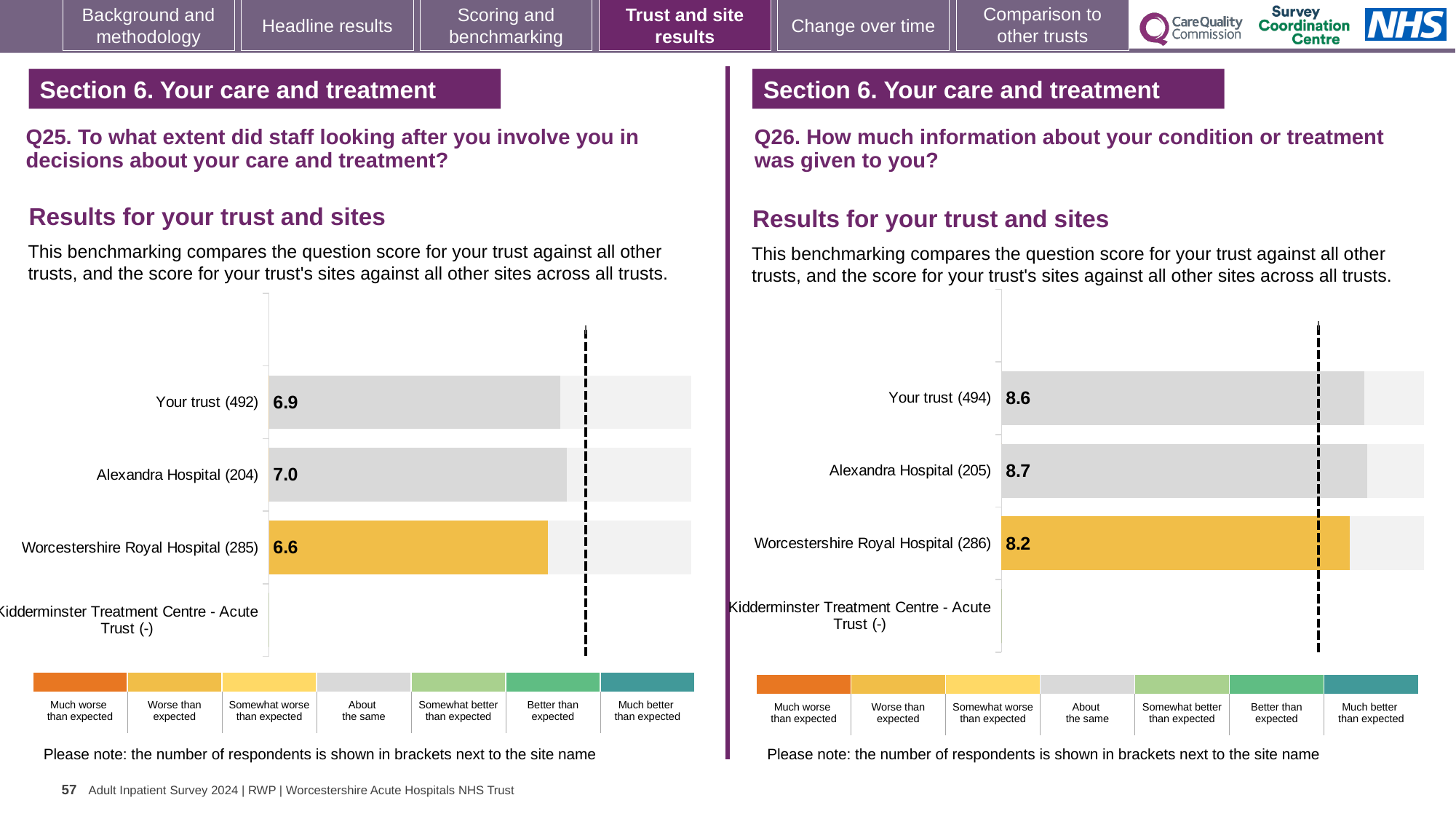
What type of chart is used for the Q26 results (right)? Bar chart On the Q26 chart (right), what is the score for Alexandra Hospital (205)? 8.7 On the Q26 chart (right), which has the larger score: Your trust (494) or Worcestershire Royal Hospital (286)? Your trust (494) On the Q25 chart (left), what is the score for Your trust (492)? 6.9 On the Q25 chart (left), which site's bar is coloured yellow/orange rather than grey? Worcestershire Royal Hospital (285) On the Q25 chart (left), what is the score for Worcestershire Royal Hospital (285)? 6.6 How many categories (rows) are listed on the Q25 chart (left)? 4 On the Q25 chart (left), what is the difference between the scores for Alexandra Hospital (204) and Worcestershire Royal Hospital (285)? 0.4 On the Q26 chart (right), what is the score for Worcestershire Royal Hospital (286)? 8.2 On the Q25 chart (left), which site or trust has the highest score? Alexandra Hospital (204) On the Q26 chart (right), what is the difference between the scores for Your trust (494) and Worcestershire Royal Hospital (286)? 0.4 On the Q26 chart (right), which site or trust has the lowest score? Worcestershire Royal Hospital (286)